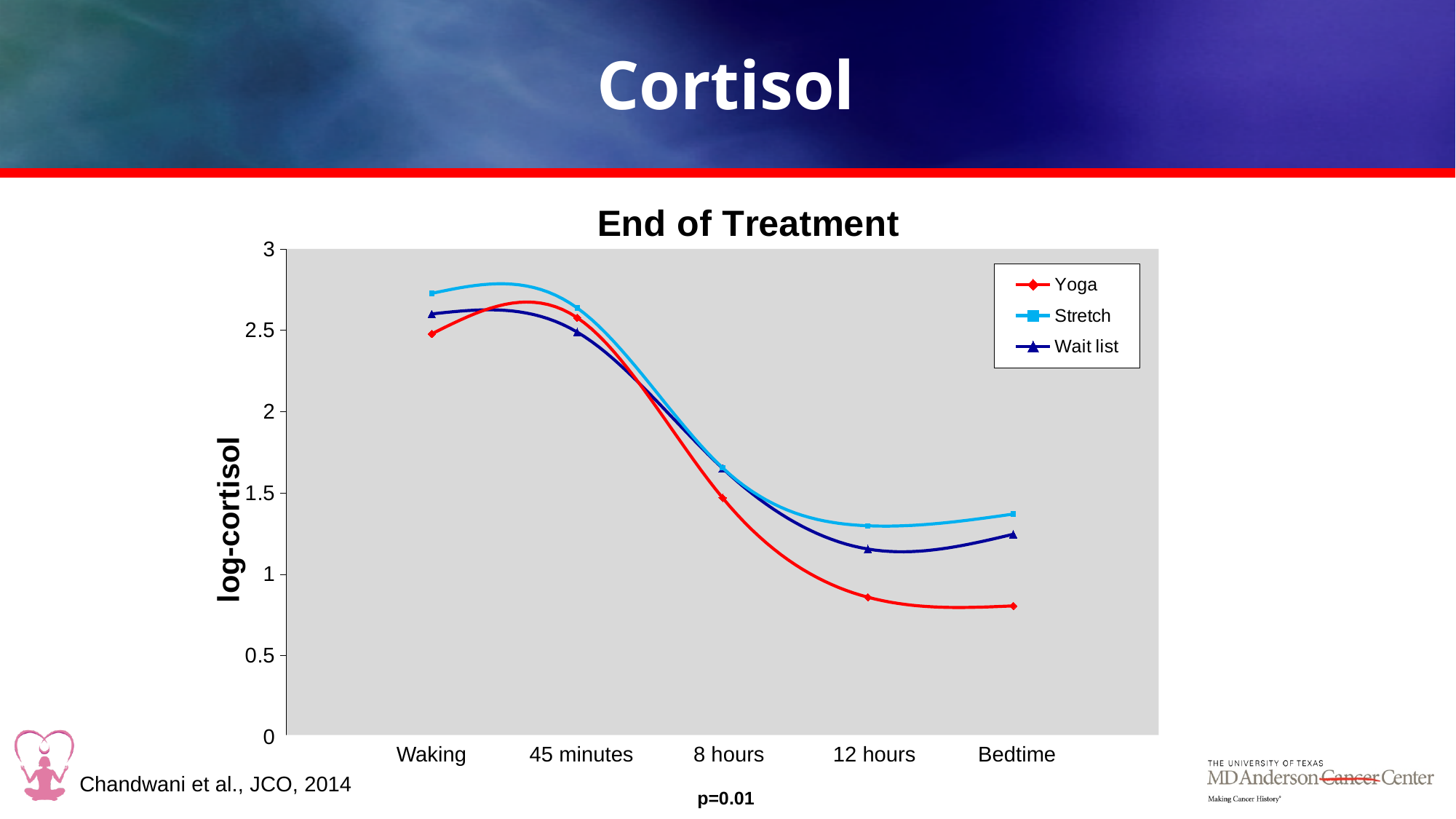
At 12 hours, which is larger: Yoga or Wait list? Wait list How many series does the legend list? 3 What kind of chart is shown on the slide? Line chart Which series has the highest value at Waking? Stretch What is the label of the y axis? log-cortisol How many time points are shown on the x axis? 5 Is the value for Yoga at Bedtime greater or less than 1? less What is the title of the chart? End of Treatment Is the value for Stretch at Waking greater or less than 2.5? greater Is the value for Wait list at 12 hours greater or less than 1? greater Which series has the lowest value at Bedtime? Yoga Does the Stretch series rise or fall from 45 minutes to 12 hours? Fall